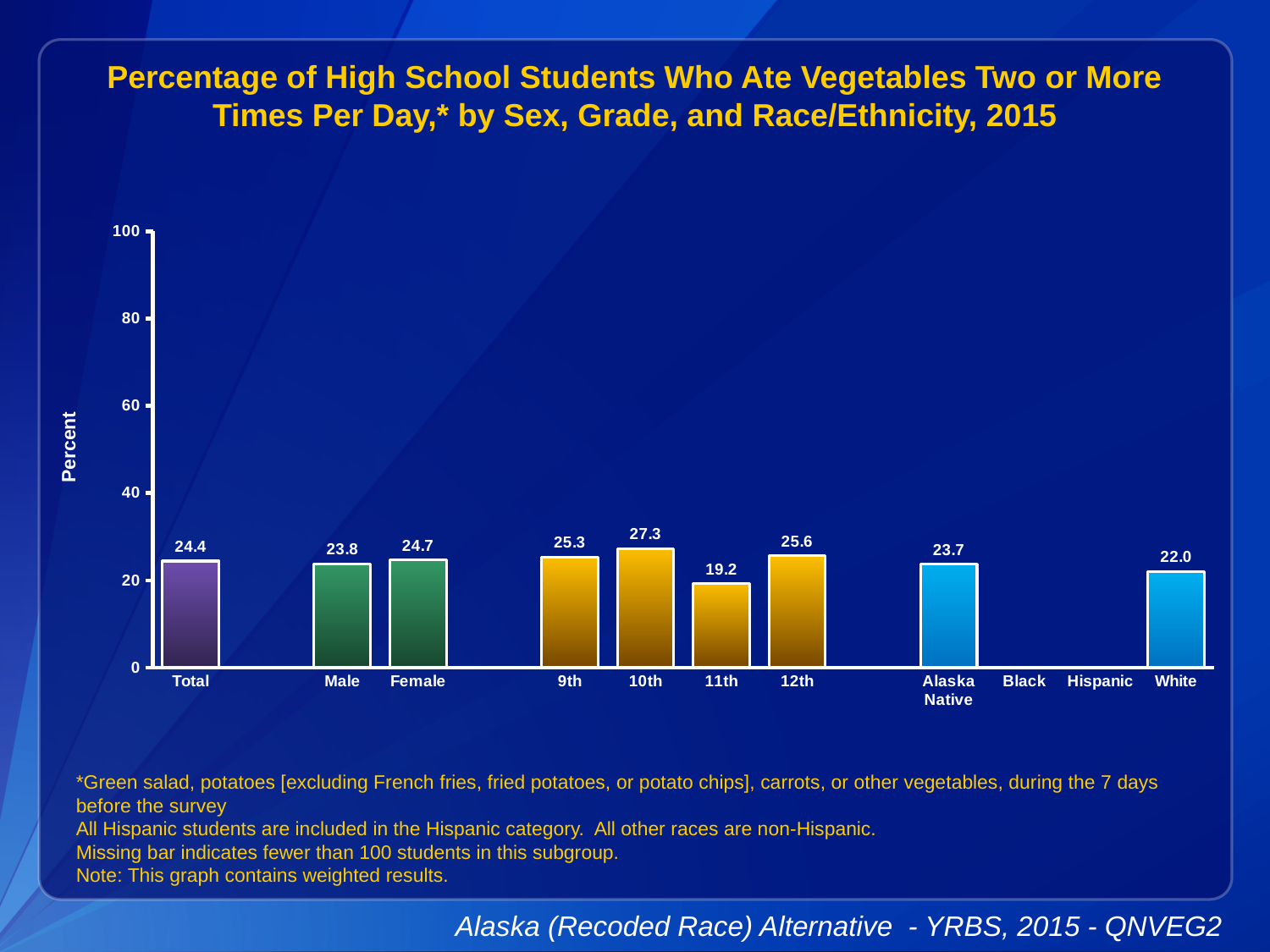
Which category with a plotted bar has the lowest value? 11th What is the difference between the values for Female and Male? 0.9 Is the value for 10th grade greater or less than 40? less How many categories are labeled on the x axis? 11 What kind of chart is shown on the slide? bar chart What is the value for Alaska Native students? 23.7 Which category has the highest value? 10th Which is larger, the value for 12th grade or the value for White students? 12th grade What is the difference between the values for 10th and 11th grade? 8.1 What is the value for Total? 24.4 What is the value for 11th grade students? 19.2 Which categories on the x axis have no bar plotted? Black and Hispanic